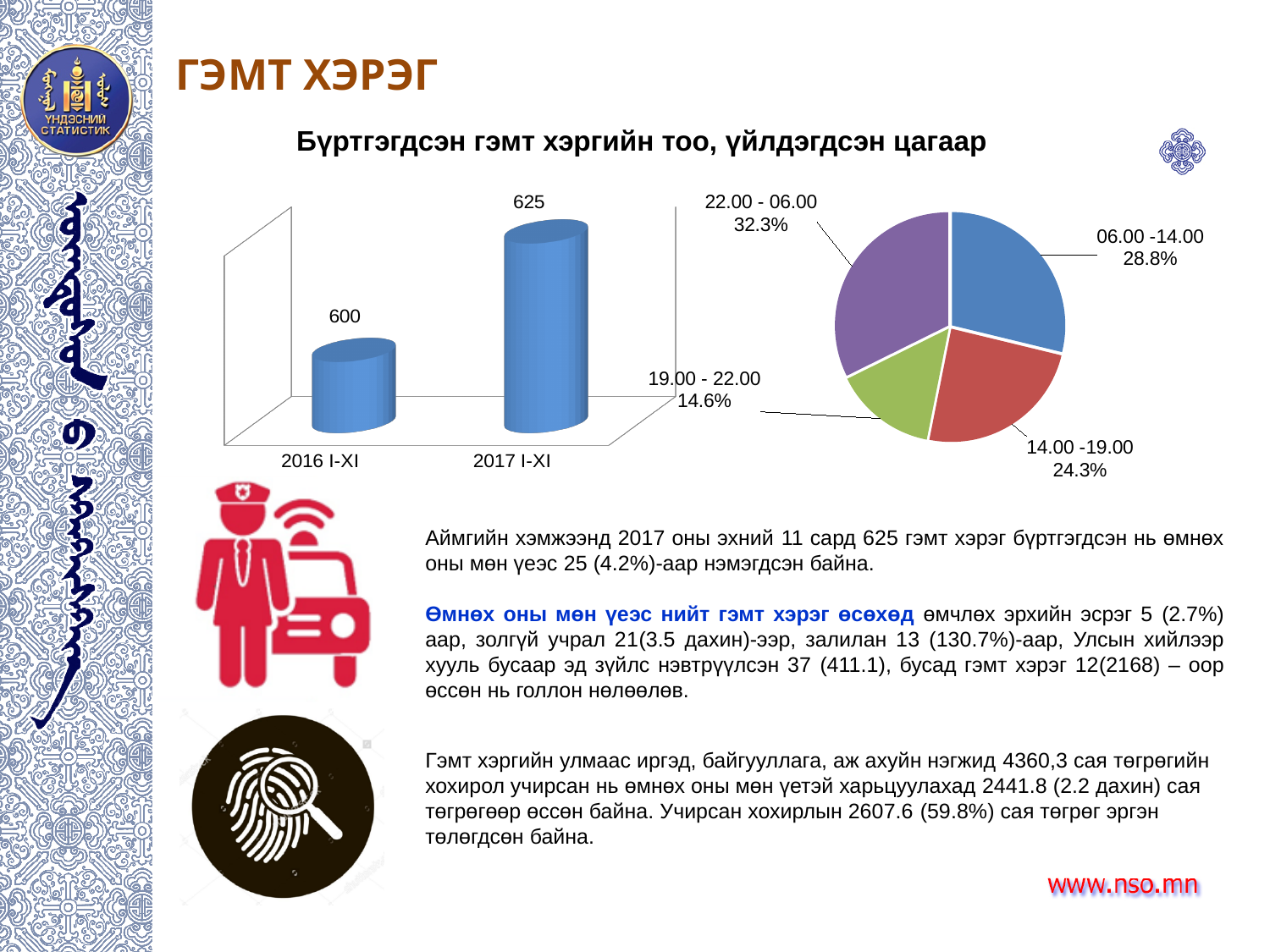
On the pie chart on the right, which time period has the smallest share? 19.00 - 22.00 On the bar chart on the left, do the values rise or fall from 2016 I-XI to 2017 I-XI? Rise On the pie chart on the right, what share does the 19.00 - 22.00 slice have? 14.6% On the bar chart on the left, how many categories are shown? 2 On the bar chart on the left, what is the value for 2017 I-XI? 625 On the pie chart on the right, what is the difference between the 06.00 -14.00 share and the 14.00 -19.00 share? 4.5% On the pie chart on the right, what share does the 22.00 - 06.00 slice have? 32.3% On the bar chart on the left, what is the value for 2016 I-XI? 600 What kind of chart is the chart on the left of the slide? Bar chart On the bar chart on the left, what is the difference between the 2017 I-XI and 2016 I-XI values? 25 On the bar chart on the left, which category has the higher value, 2016 I-XI or 2017 I-XI? 2017 I-XI On the pie chart on the right, which time period has the largest share? 22.00 - 06.00